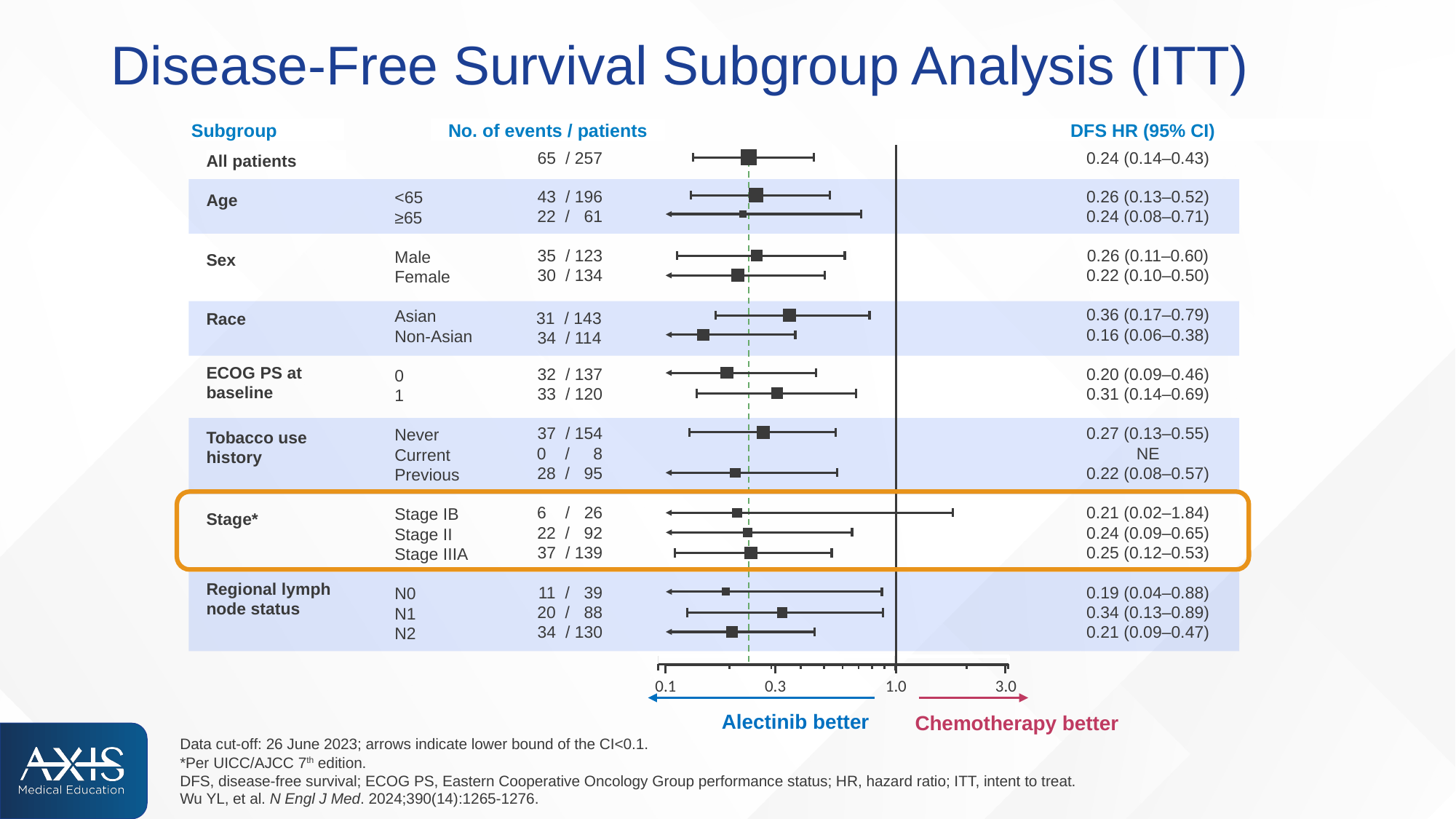
Which subgroup has the lowest DFS hazard ratio point estimate? Non-Asian (0.16) What is the DFS HR (95% CI) for All patients? 0.24 (0.14–0.43) What is the total number of patients across the two Age subgroups (<65 and ≥65)? 257 How many Stage subgroups are plotted? 3 What is the difference between the DFS hazard ratios for the Asian and Non-Asian subgroups? 0.20 Which subgroup row is highlighted with an orange box? Stage* What is the number of events / patients for Stage IIIA? 37 / 139 What is the DFS HR (95% CI) for the Non-Asian subgroup? 0.16 (0.06–0.38) Which has the larger DFS hazard ratio, ECOG PS 0 or ECOG PS 1? ECOG PS 1 What type of chart is shown on the slide? Forest plot Is the DFS hazard ratio for All patients greater or less than 1.0? less Which subgroup has the highest DFS hazard ratio point estimate? Asian (0.36)